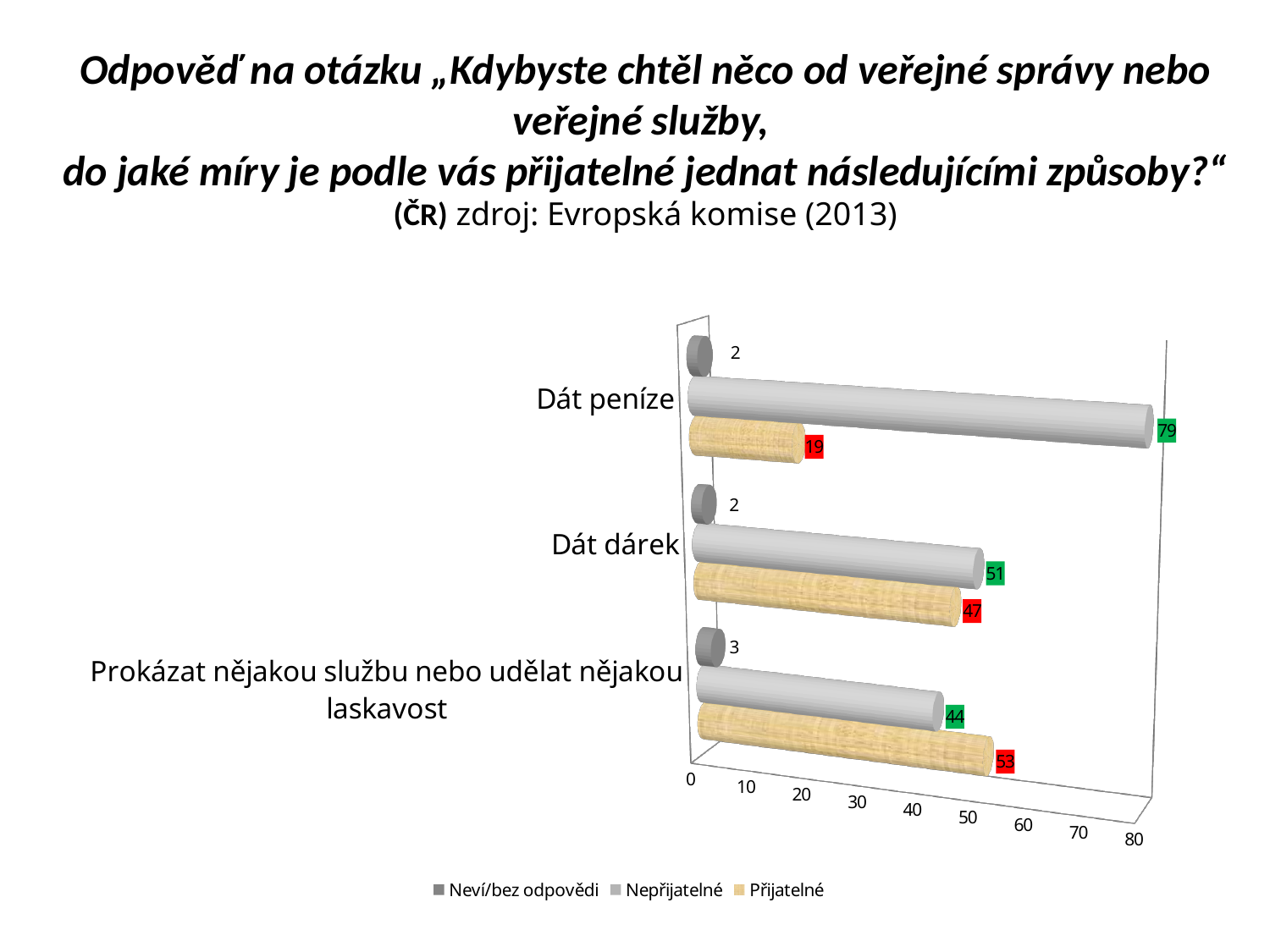
What is the value of Nepřijatelné for Dát peníze? 79 How many categories are shown on the chart? 3 What is the value of Neví/bez odpovědi for Prokázat nějakou službu nebo udělat nějakou laskavost? 3 For Prokázat nějakou službu nebo udělat nějakou laskavost, which is larger: Nepřijatelné or Přijatelné? Přijatelné How many series does the legend list? 3 What is the total of the three values for Dát dárek? 100 Which category has the lowest Přijatelné value? Dát peníze What is the value of Přijatelné for Dát peníze? 19 What kind of chart is shown on the slide? Bar chart What is the difference between the Nepřijatelné and Přijatelné values for Dát peníze? 60 What is the value of Přijatelné for Dát dárek? 47 Which category has the highest Nepřijatelné value? Dát peníze